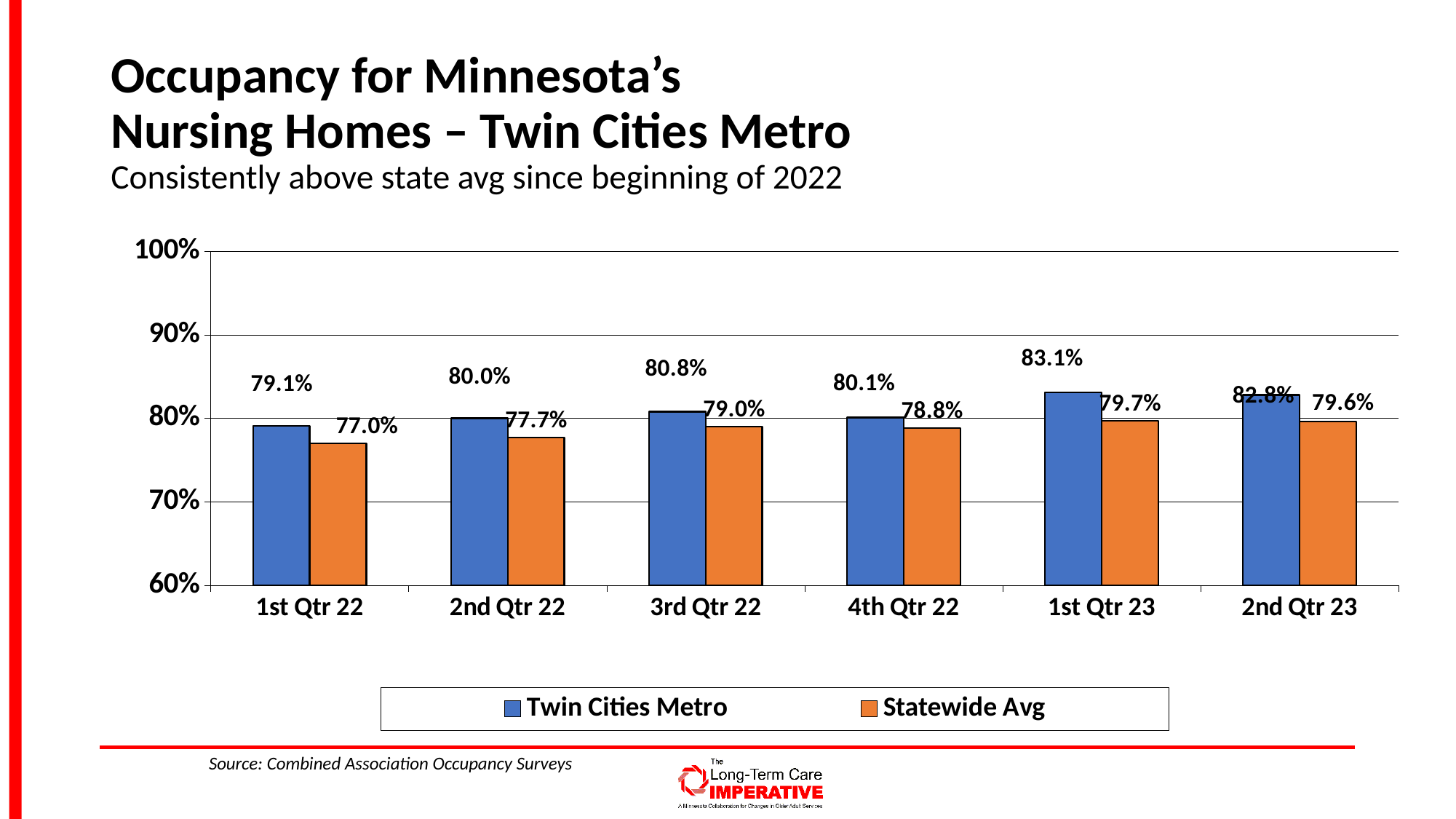
Which colour represents the Statewide Avg series? Orange How many quarters are shown on the x axis? 6 What is the Statewide Avg occupancy for 1st Qtr 22? 77.0% In which quarter is the Statewide Avg occupancy lowest? 1st Qtr 22 What kind of chart is shown on the slide? Bar chart What is the Statewide Avg occupancy for 4th Qtr 22? 78.8% Is the Statewide Avg occupancy for 2nd Qtr 22 greater or less than 80%? less Which is larger in 2nd Qtr 22: the Twin Cities Metro occupancy or the Statewide Avg occupancy? Twin Cities Metro What is the Twin Cities Metro occupancy for 1st Qtr 23? 83.1% In which quarter is the Twin Cities Metro occupancy highest? 1st Qtr 23 How many series does the legend list? 2 What is the difference between the Twin Cities Metro and Statewide Avg occupancy in 3rd Qtr 22? 1.8%